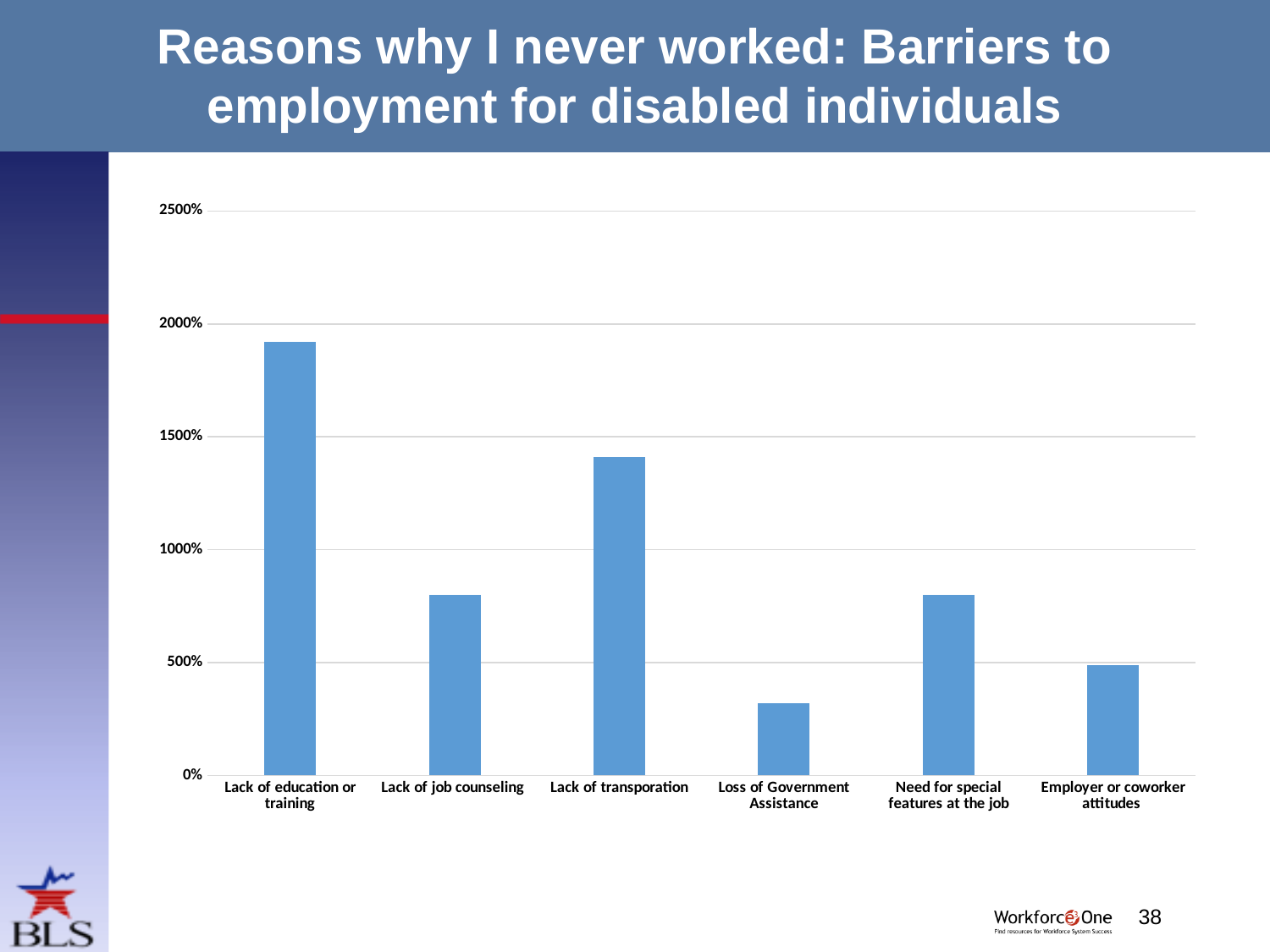
What is the title of the slide containing the chart? Reasons why I never worked: Barriers to employment for disabled individuals How many categories (barriers) are shown on the x axis of the chart? 6 Which is larger: the value for Employer or coworker attitudes or the value for Loss of Government Assistance? Employer or coworker attitudes Which barrier has the lowest bar in the chart? Loss of Government Assistance Is the value for Lack of transporation greater or less than 1000%? greater Which barrier has the highest bar in the chart? Lack of education or training What type of chart is shown on the slide? bar chart Is the value for Lack of job counseling greater or less than 1000%? less Is the value for Need for special features at the job greater or less than 500%? greater Which is larger: the value for Lack of education or training or the value for Lack of transporation? Lack of education or training